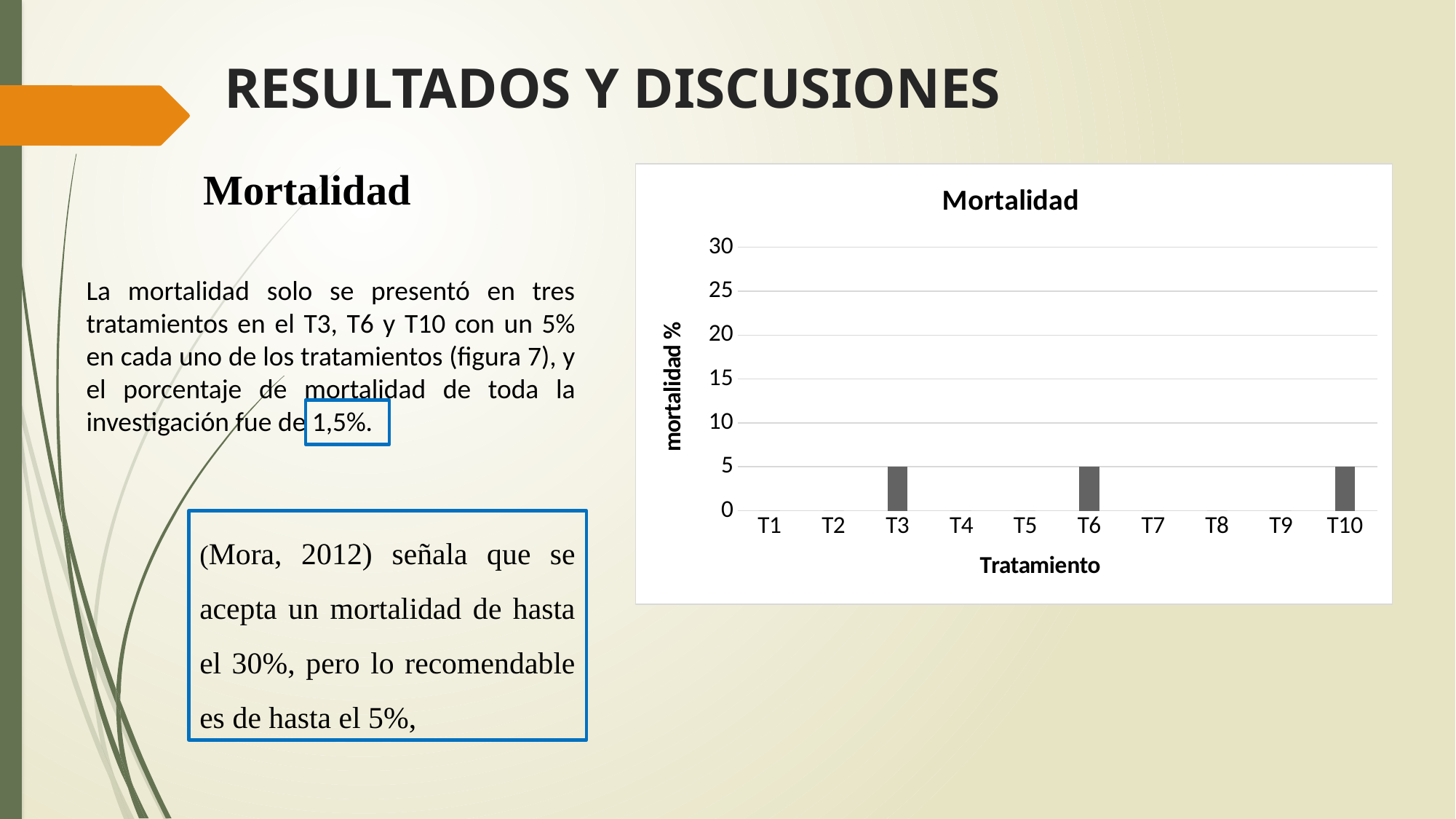
What is the mortality value for T3 in the Mortalidad chart? 5 Is the value for T3 greater or less than 25? less Which has a larger value in the Mortalidad chart, T3 or T1? T3 Is the value for T6 greater or less than 10? less Which has a larger value in the Mortalidad chart, T7 or T10? T10 What is the title of the chart? Mortalidad How many treatments in the Mortalidad chart have a visible bar? 3 What is the mortality value for T10 in the Mortalidad chart? 5 What kind of chart is shown on the slide? bar chart How many treatment categories are shown on the x axis of the Mortalidad chart? 10 What is the x-axis title of the chart? Tratamiento What is the mortality value for T6 in the Mortalidad chart? 5